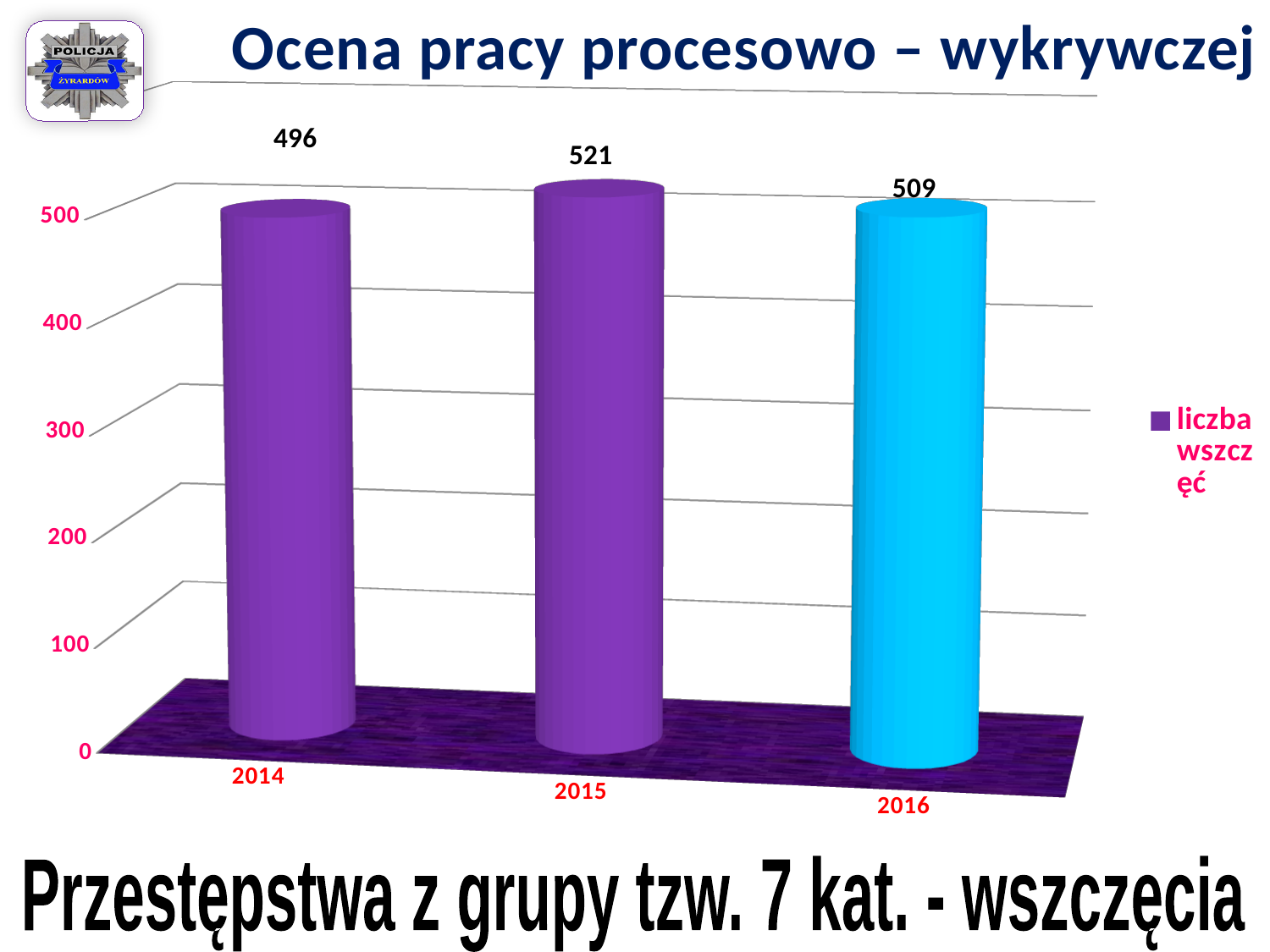
What is the difference between the values for 2015 and 2014? 25 Which year has the lowest value? 2014 How many years are shown on the x axis? 3 What is the value for 2016? 509 Which year has the highest value? 2015 What kind of chart is shown on the slide? bar chart What is the difference between the values for 2015 and 2016? 12 What is the value for 2014? 496 Which is larger, the value for 2016 or the value for 2014? 2016 What is the value for 2015? 521 How many series does the legend list? 1 What is the legend entry of the chart? liczba wszczęć